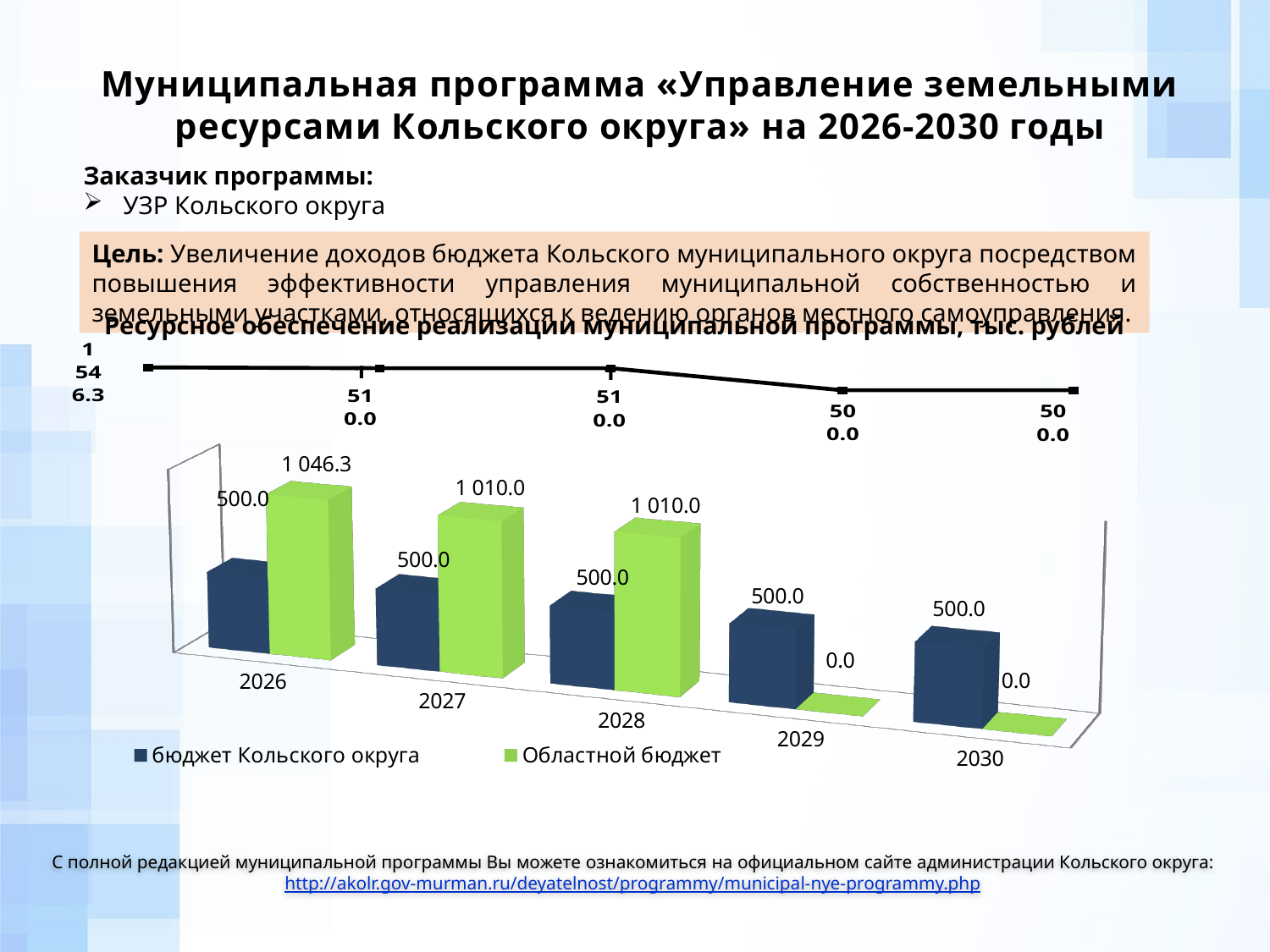
In which year is the Областной бюджет value the highest? 2026 What kind of chart is shown on the slide? a line chart and a 3D bar chart In 2027, which series has the larger value: бюджет Кольского округа or Областной бюджет? Областной бюджет Does the Областной бюджет value rise or fall from 2026 to 2030? fall What is the difference between Областной бюджет and бюджет Кольского округа in 2026? 546.3 How many series does the chart legend list? 2 How many years are shown on the x axis of the chart? 5 What is the value for Областной бюджет in 2029? 0.0 What is the value for Областной бюджет in 2026? 1 046.3 By how much does Областной бюджет decrease from 2026 to 2027? 36.3 What is the value for бюджет Кольского округа in 2028? 500.0 What is the title of the chart? Ресурсное обеспечение реализации муниципальной программы, тыс. рублей